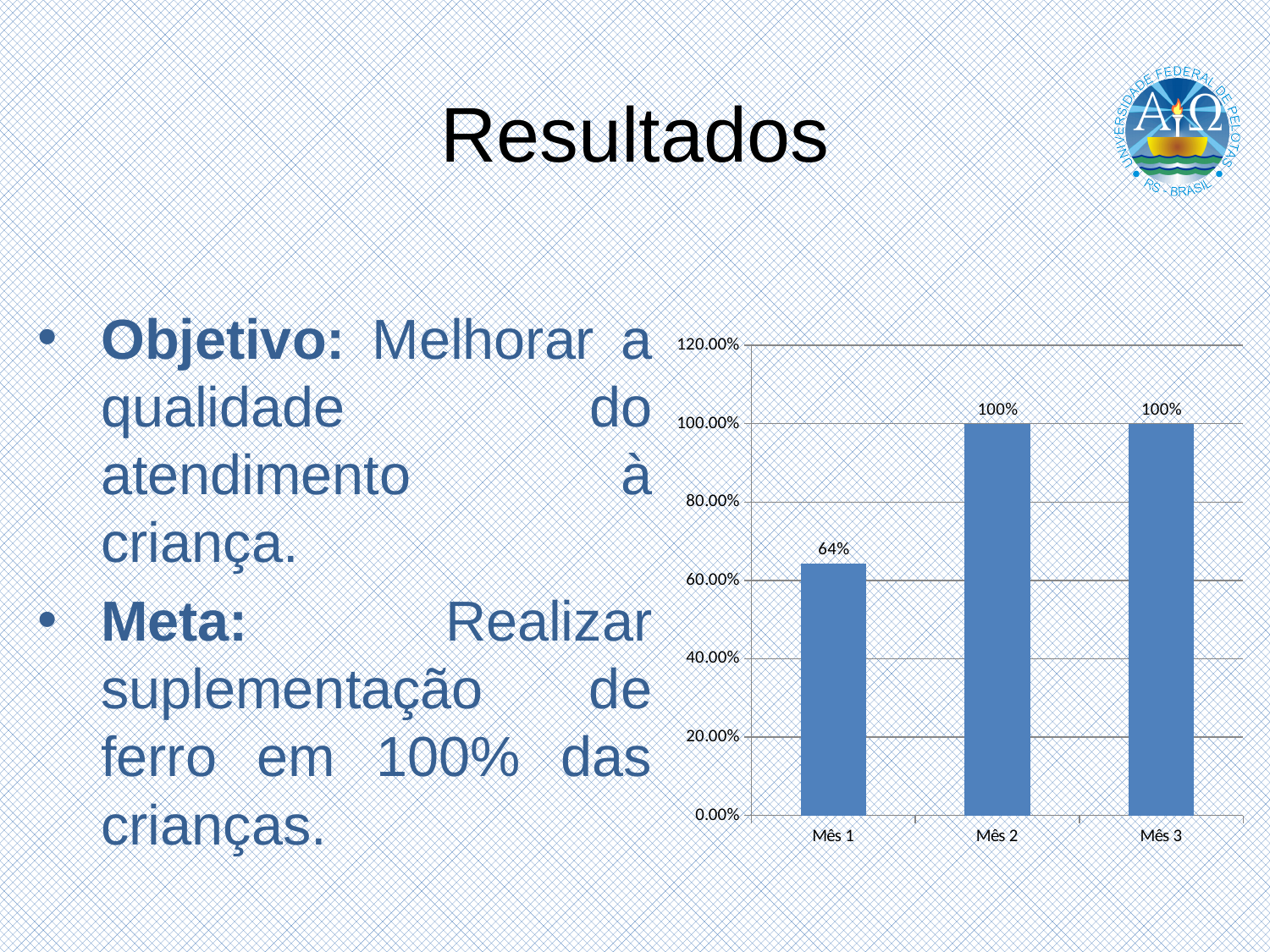
What is the value for Mês 1? 64% What is the value for Mês 2? 100% Is the value for Mês 2 greater or less than 80.00%? greater What is the difference between the values for Mês 2 and Mês 1? 36% Which category has the lowest value? Mês 1 How many categories are shown on the x axis? 3 Do the values rise or fall from Mês 1 to Mês 2? rise What kind of chart is shown on the slide? bar chart Is the value for Mês 1 greater or less than 80.00%? less Which is larger, the value for Mês 1 or the value for Mês 3? Mês 3 What is the highest tick value shown on the y axis? 120.00% What is the value for Mês 3? 100%